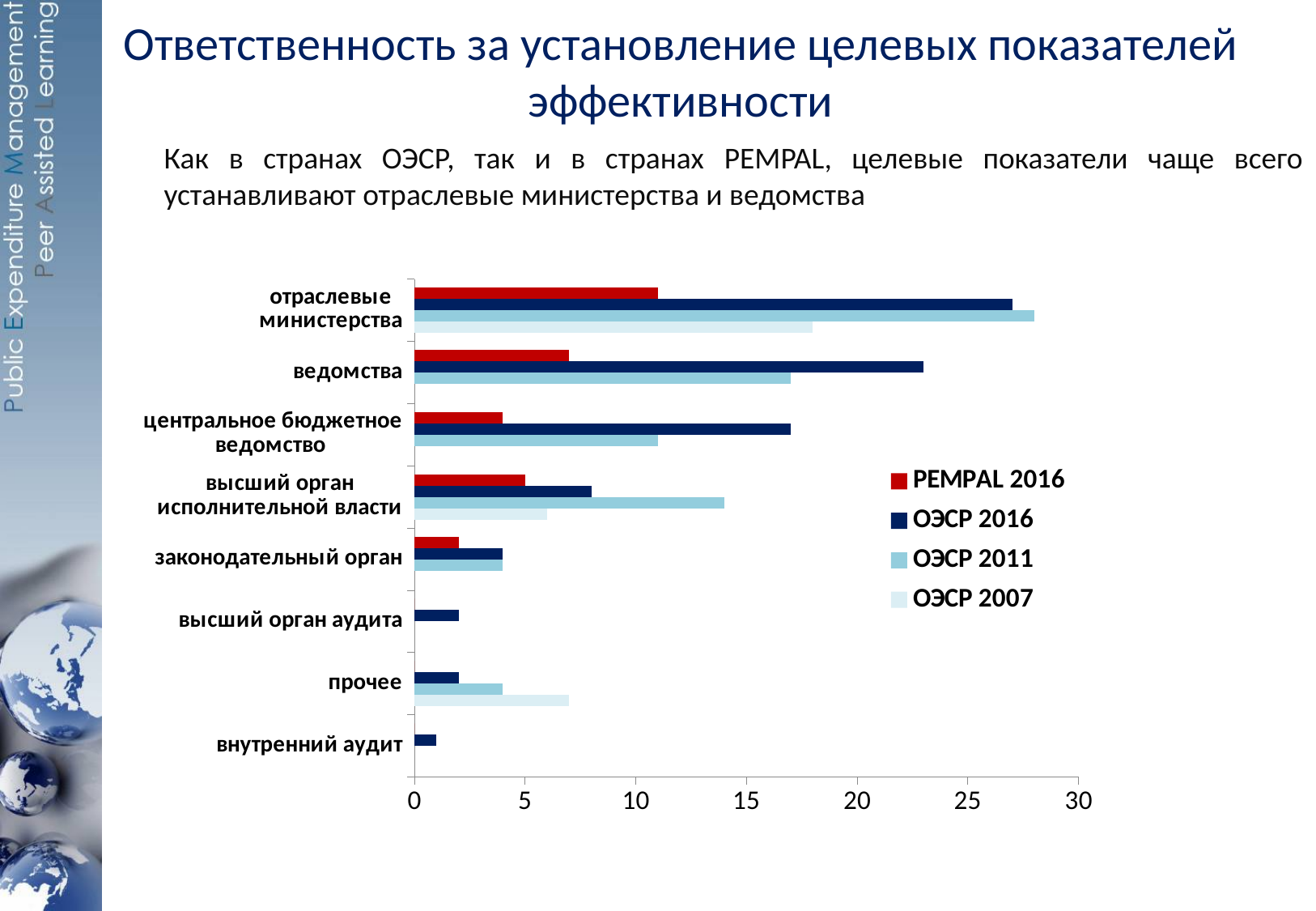
Which category has the highest value for the PEMPAL 2016 series? отраслевые министерства For высший орган исполнительной власти, which is larger: the ОЭСР 2011 value or the ОЭСР 2016 value? ОЭСР 2011 What kind of chart is shown on the slide? bar chart For ведомства, which is larger: the ОЭСР 2016 value or the ОЭСР 2011 value? ОЭСР 2016 Is the ОЭСР 2016 value for ведомства greater or less than 20? greater How many series does the legend list? 4 Which category has the highest value for the ОЭСР 2016 series? отраслевые министерства What colour represents the PEMPAL 2016 series in the legend? red Is the PEMPAL 2016 value for отраслевые министерства greater or less than 15? less Is the ОЭСР 2016 value for центральное бюджетное ведомство greater or less than 15? greater How many categories are shown on the vertical axis of the chart? 8